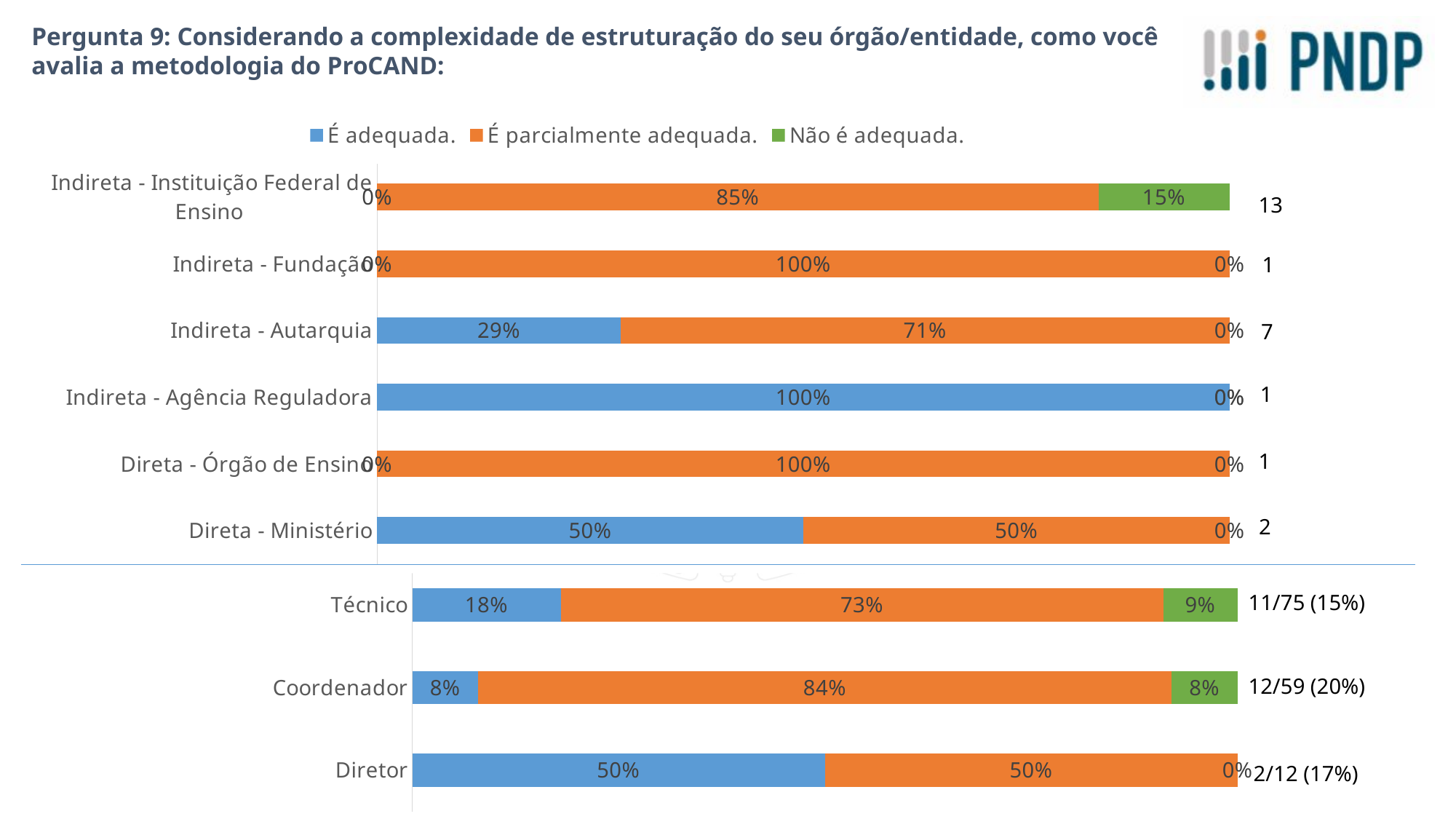
In the bottom chart, which role has the highest share of 'É adequada.' responses? Diretor In the bottom chart, what percentage of Técnico respondents answered 'Não é adequada.'? 9% In the top chart, what percentage of Indireta - Autarquia respondents answered 'É adequada.'? 29% In the bottom chart, what is the difference between the 'É parcialmente adequada.' shares for Coordenador and Técnico? 11% In the bottom chart, what percentage of Coordenador respondents answered 'É parcialmente adequada.'? 84% In the top chart, which is larger: the 'É adequada.' share for Direta - Ministério or for Indireta - Autarquia? Direta - Ministério In the top chart, what percentage of Indireta - Agência Reguladora respondents answered 'É adequada.'? 100% How many categories are shown in the top chart? 6 What kind of chart is the bottom chart? Stacked bar chart In the bottom chart, which role has the lowest share of 'É adequada.' responses? Coordenador How many series does the legend list? 3 In the top chart, what percentage of Indireta - Instituição Federal de Ensino respondents answered 'Não é adequada.'? 15%